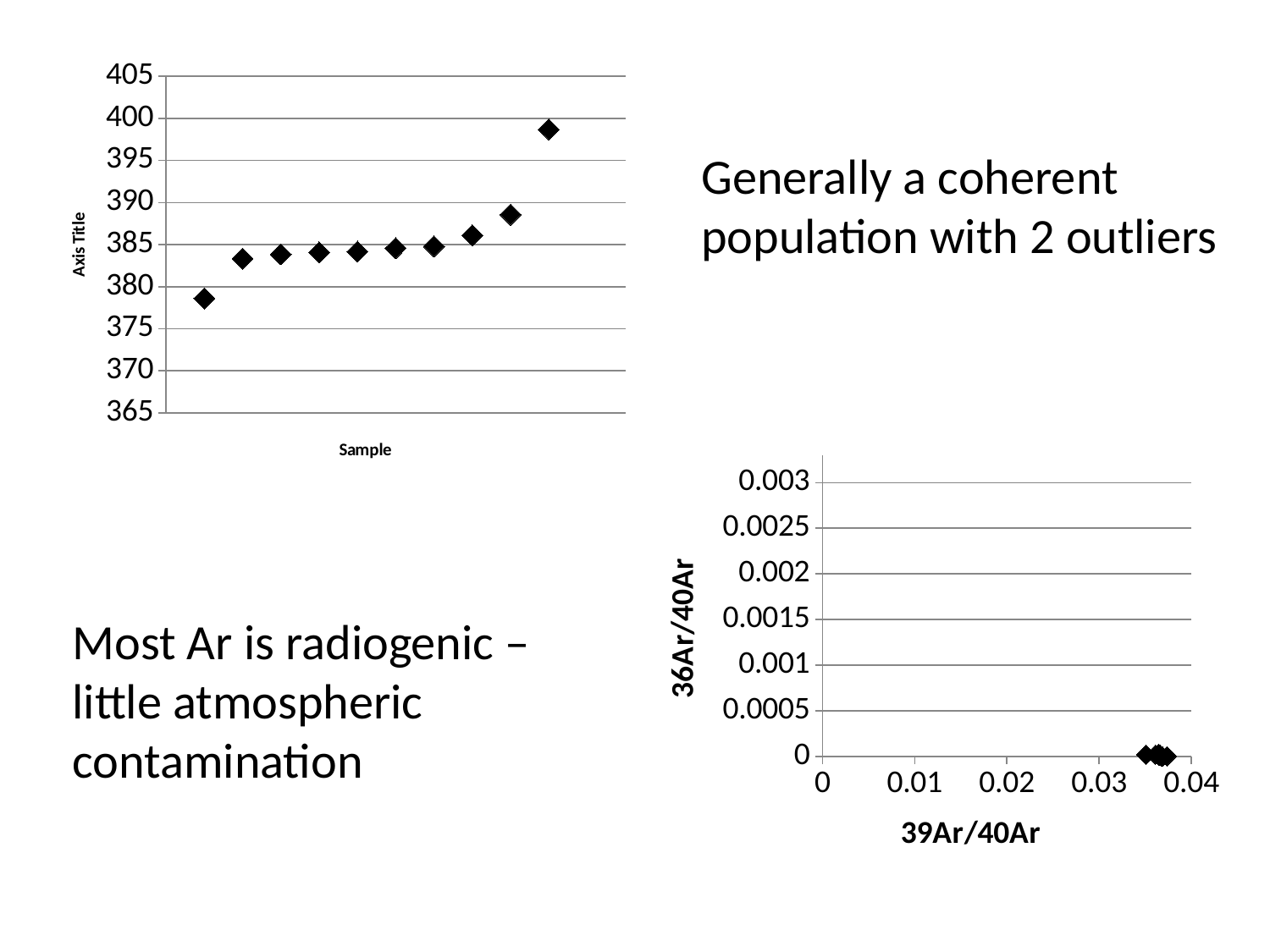
What kind of chart is the bottom-right chart with the x-axis labelled "39Ar/40Ar"? scatter chart On the bottom-right chart with the x-axis labelled "39Ar/40Ar", are the plotted 36Ar/40Ar values greater or less than 0.0005? less On the top-left chart with the x-axis labelled "Sample", is the value of the rightmost point greater or less than 395? greater On the top-left chart with the x-axis labelled "Sample", what is the label of the y-axis? Axis Title On the top-left chart with the x-axis labelled "Sample", which point has the highest value, the leftmost or the rightmost? the rightmost What kind of chart is the top-left chart with the x-axis labelled "Sample"? scatter chart What is the y-axis label of the bottom-right chart? 36Ar/40Ar On the bottom-right chart with the x-axis labelled "39Ar/40Ar", are the plotted 39Ar/40Ar values greater or less than 0.03? greater On the top-left chart with the x-axis labelled "Sample", do the values generally rise or fall from left to right? rise How many data points are plotted on the top-left chart with the x-axis labelled "Sample"? 10 On the top-left chart with the x-axis labelled "Sample", what is the maximum value shown on the y-axis? 405